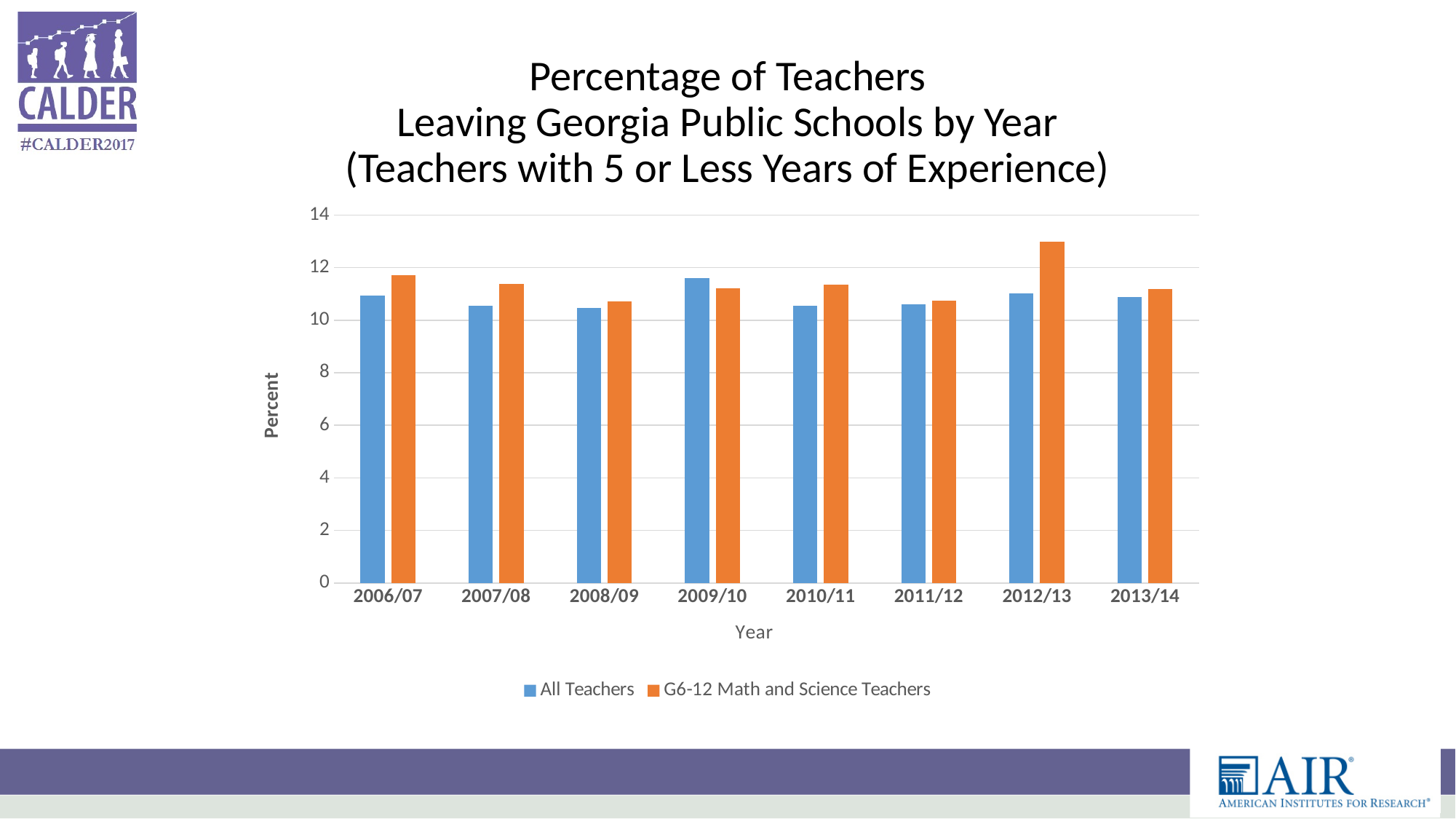
Is the value for All Teachers in 2008/09 greater or less than 10? greater How many years are shown on the x axis? 8 Which colour represents G6-12 Math and Science Teachers in the legend? Orange In which year is the value for All Teachers highest? 2009/10 Is the value for G6-12 Math and Science Teachers in 2012/13 greater or less than 12? greater What kind of chart is shown on the slide? Bar chart In which year is the value for G6-12 Math and Science Teachers highest? 2012/13 Is the value for G6-12 Math and Science Teachers in 2006/07 greater or less than 12? less What is the label on the vertical axis? Percent In 2009/10, which series has the larger value, All Teachers or G6-12 Math and Science Teachers? All Teachers In 2012/13, which series has the larger value, All Teachers or G6-12 Math and Science Teachers? G6-12 Math and Science Teachers How many series does the legend list? 2